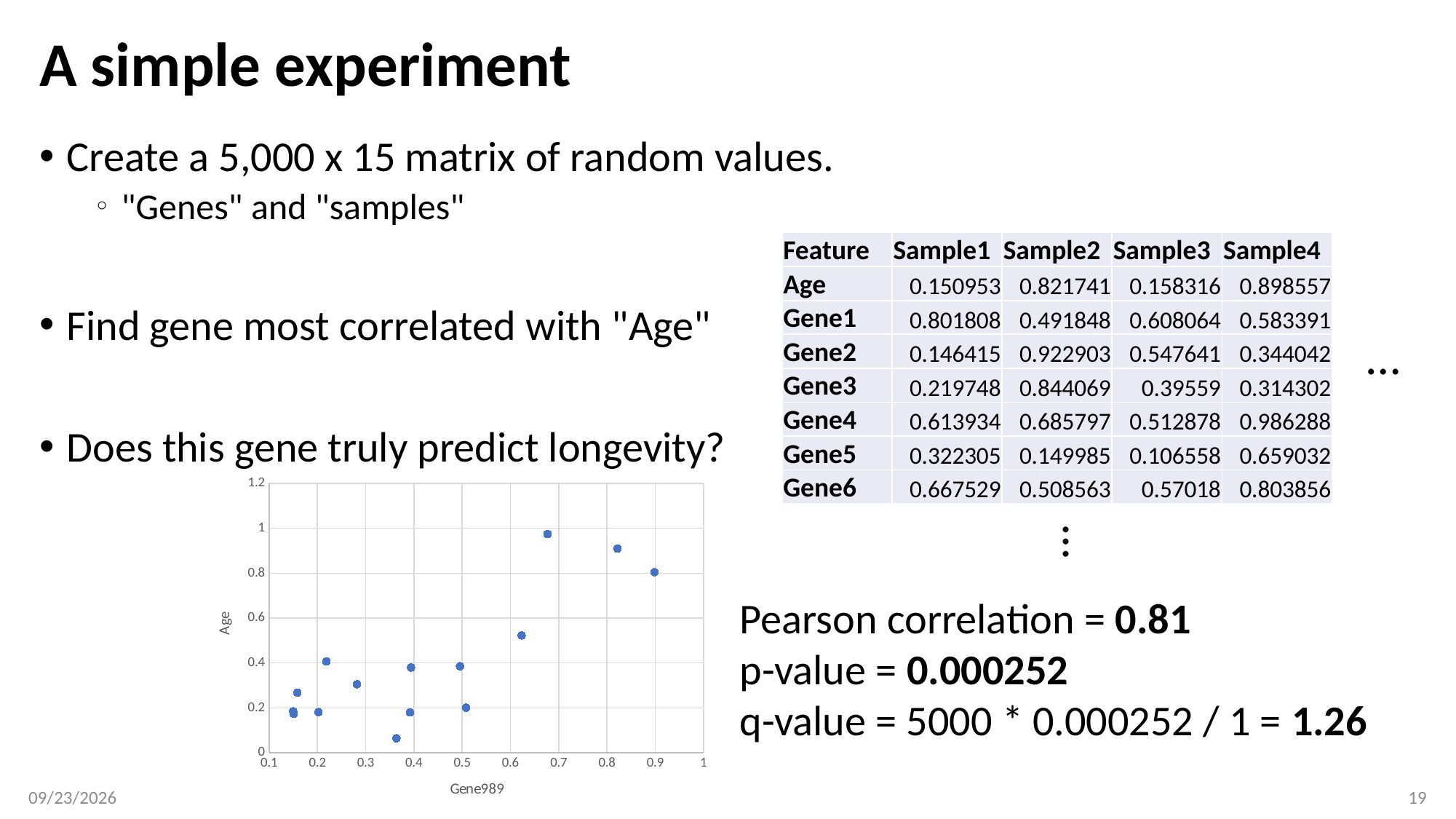
In the scatter chart, is the Age value of the lowest point greater or less than 0.2? less What is the highest tick value shown on the y axis of the scatter chart? 1.2 In the scatter chart, is the Age value of the point with the largest Gene989 value (near 0.9) greater or less than 0.6? greater What is the label on the x axis of the scatter chart? Gene989 In the scatter chart, do the Age values generally rise or fall as Gene989 increases along the x axis? rise Which point has the higher Age value in the scatter chart: the one at Gene989 of about 0.68 or the one at about 0.62? the one at about 0.68 In the scatter chart, is the Age value of the point at Gene989 of about 0.62 greater or less than 0.8? less What kind of chart is shown on the slide? scatter chart What is the label on the y axis of the scatter chart? Age